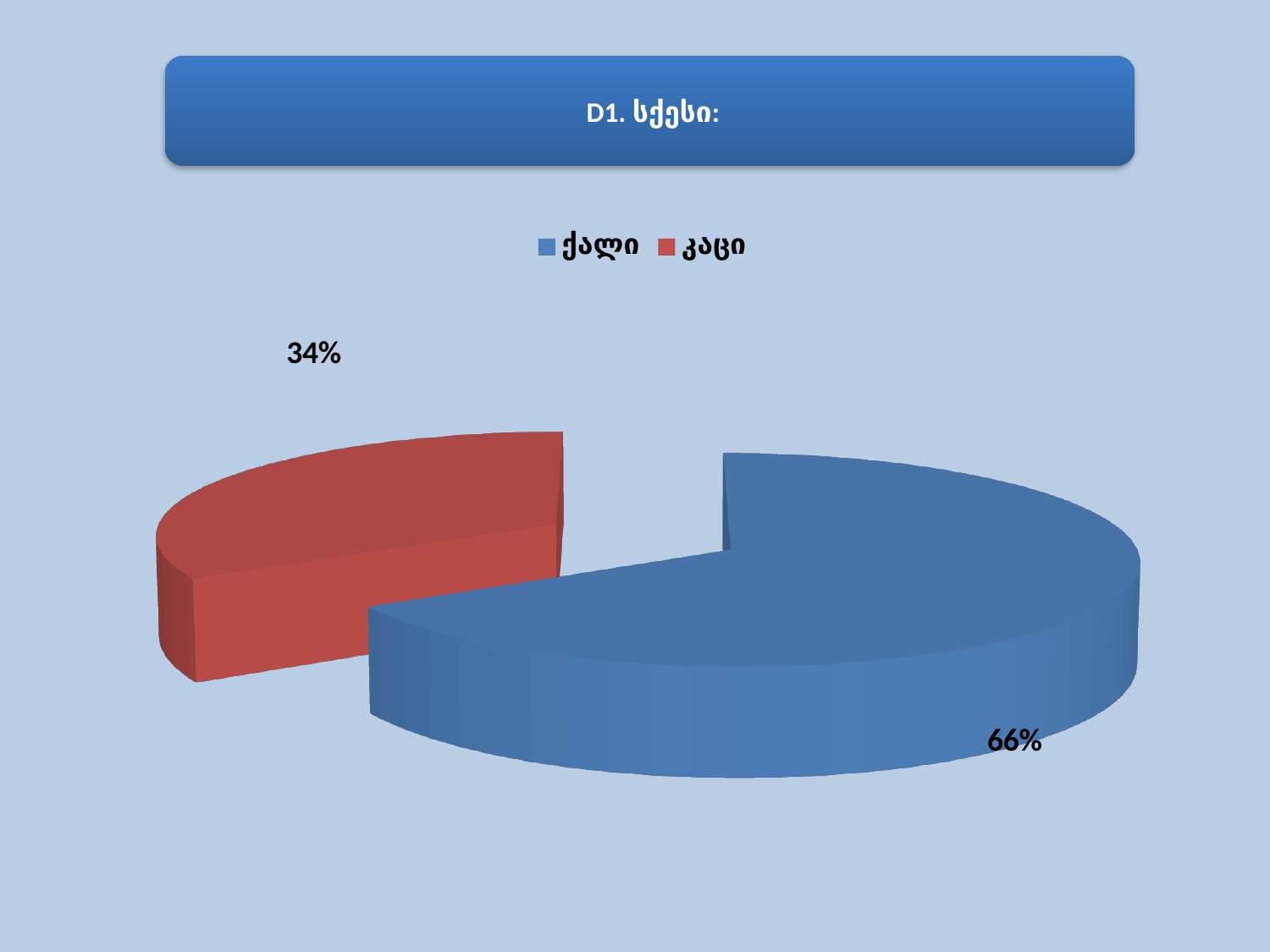
What kind of chart is shown on the slide? pie chart Which slice is larger, ქალი or კაცი? ქალი What share of the pie does ქალი represent? 66% Which category has the largest slice of the pie? ქალი What colour is the slice for კაცი? red What is the title of the chart? D1. სქესი: What share of the pie does კაცი represent? 34% Which category has the smallest slice of the pie? კაცი How many entries does the legend list? 2 What is the total of the two slices shown? 100% How many categories are shown in the pie chart? 2 What is the difference in percentage points between the ქალი and კაცი slices? 32